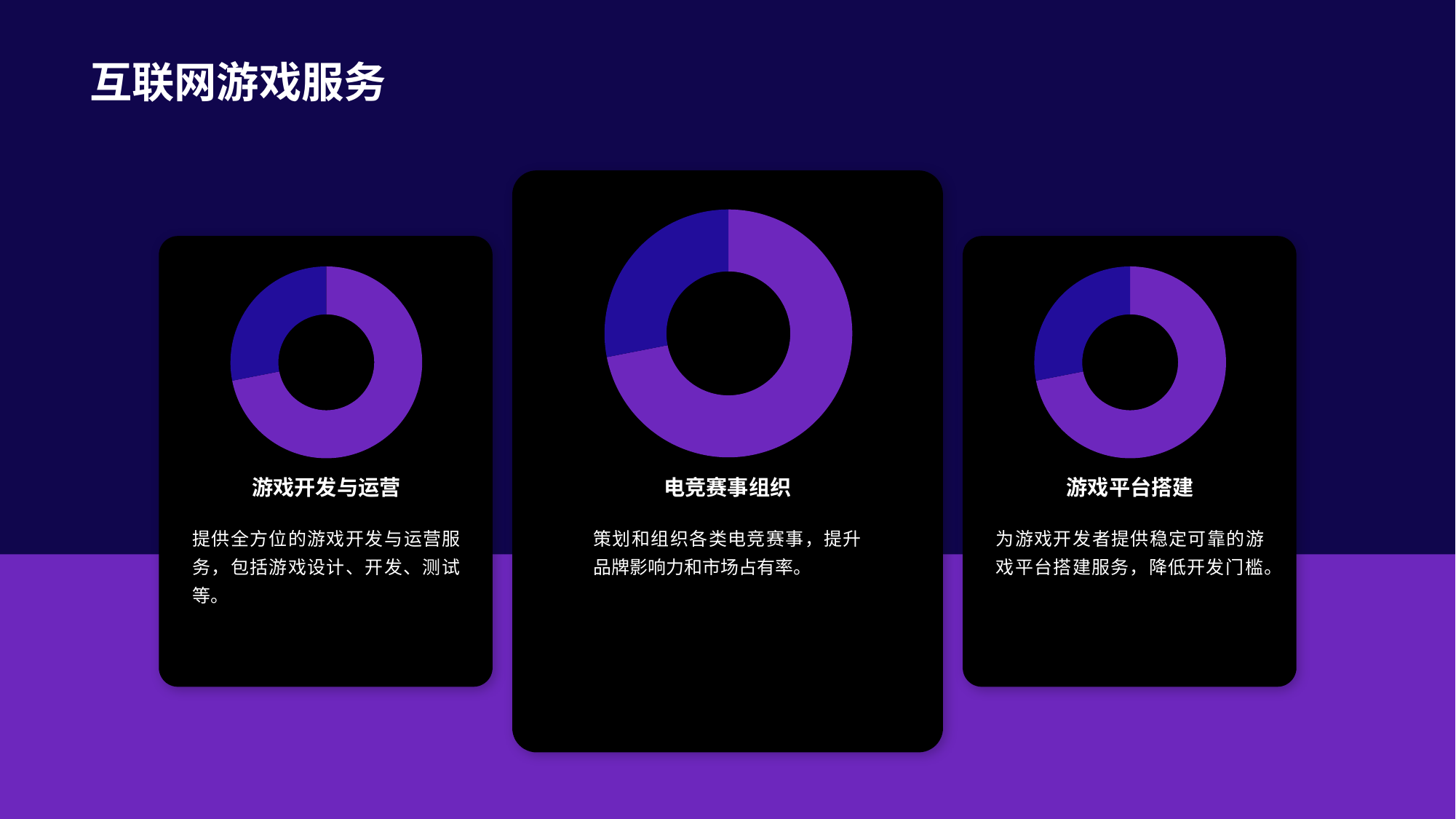
How many donut charts are shown on the slide? 3 How many slices does the donut chart on the 游戏开发与运营 card have? 2 In the donut chart on the 电竞赛事组织 card, which slice is larger, the purple one or the dark blue one? The purple one How many slices does the donut chart on the 游戏平台搭建 card have? 2 In the donut chart on the 游戏开发与运营 card, which slice is larger, the purple one or the dark blue one? The purple one What kind of chart is shown on the 电竞赛事组织 card? Donut (pie) chart What kind of chart is shown on the 游戏开发与运营 card? Donut (pie) chart In the donut chart on the 游戏平台搭建 card, which slice is smaller, the purple one or the dark blue one? The dark blue one What is the title of the card containing the middle (largest) donut chart? 电竞赛事组织 How many slices does the donut chart on the 电竞赛事组织 card have? 2